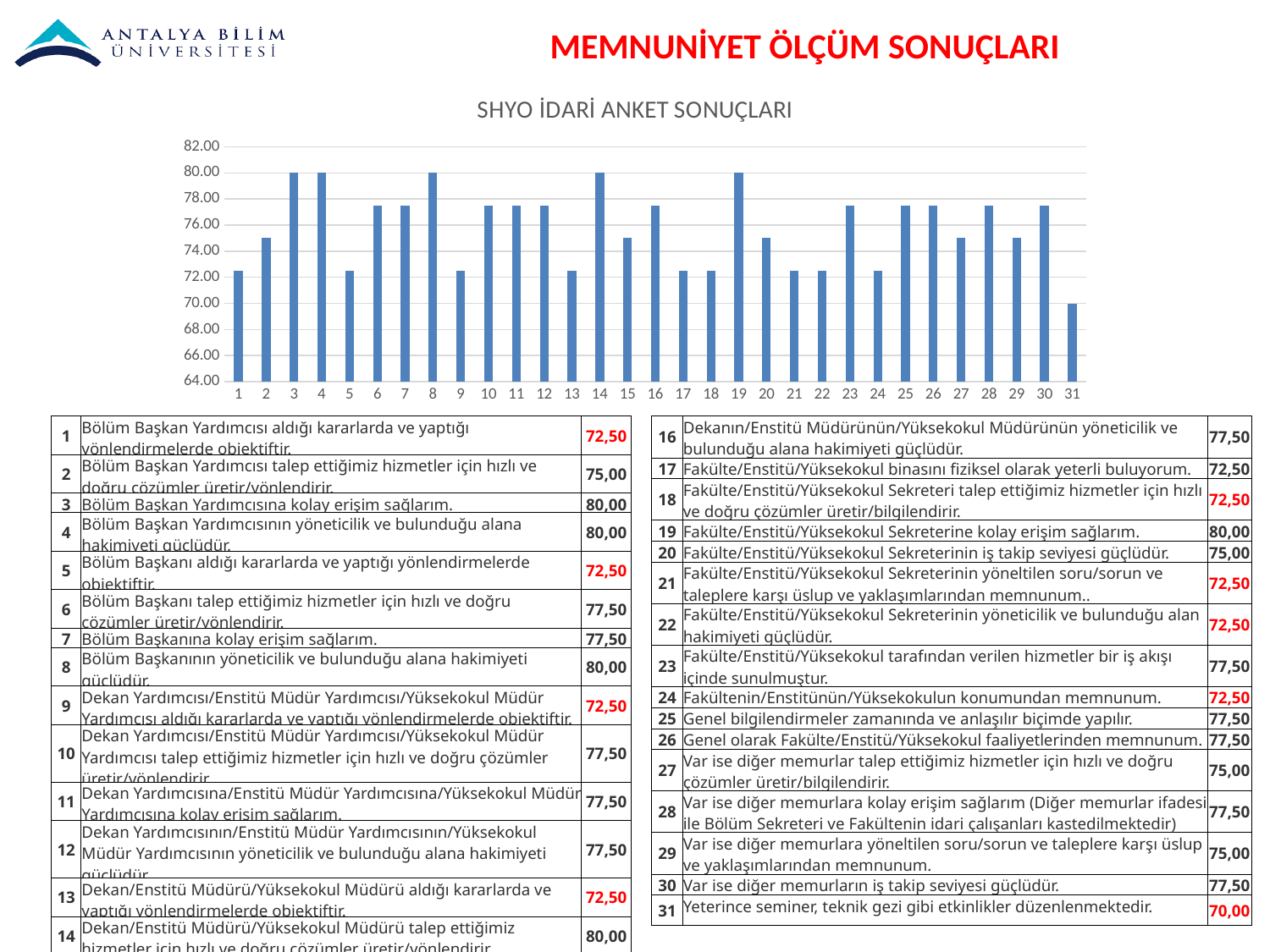
How many categories are plotted along the x axis of the chart? 31 What is the difference between the value for item 3 and the value for item 31? 10,00 What is the value for item 16 (Dekanın/Enstitü Müdürünün/Yüksekokul Müdürünün yöneticilik ve bulunduğu alana hakimiyeti güçlüdür)? 77,50 What is the value for item 31 (Yeterince seminer, teknik gezi gibi etkinlikler düzenlenmektedir)? 70,00 Is the value for category 31 greater or less than 72.00? less What is the value for item 3 (Bölüm Başkan Yardımcısına kolay erişim sağlarım)? 80,00 What is the title of the chart? SHYO İDARİ ANKET SONUÇLARI What kind of chart is shown on the slide? bar chart Is the value for category 2 greater or less than 74.00? greater Is the value for category 19 greater or less than 78.00? greater Which category has the lowest bar in the chart? 31 Which has the larger value, category 14 or category 15? 14